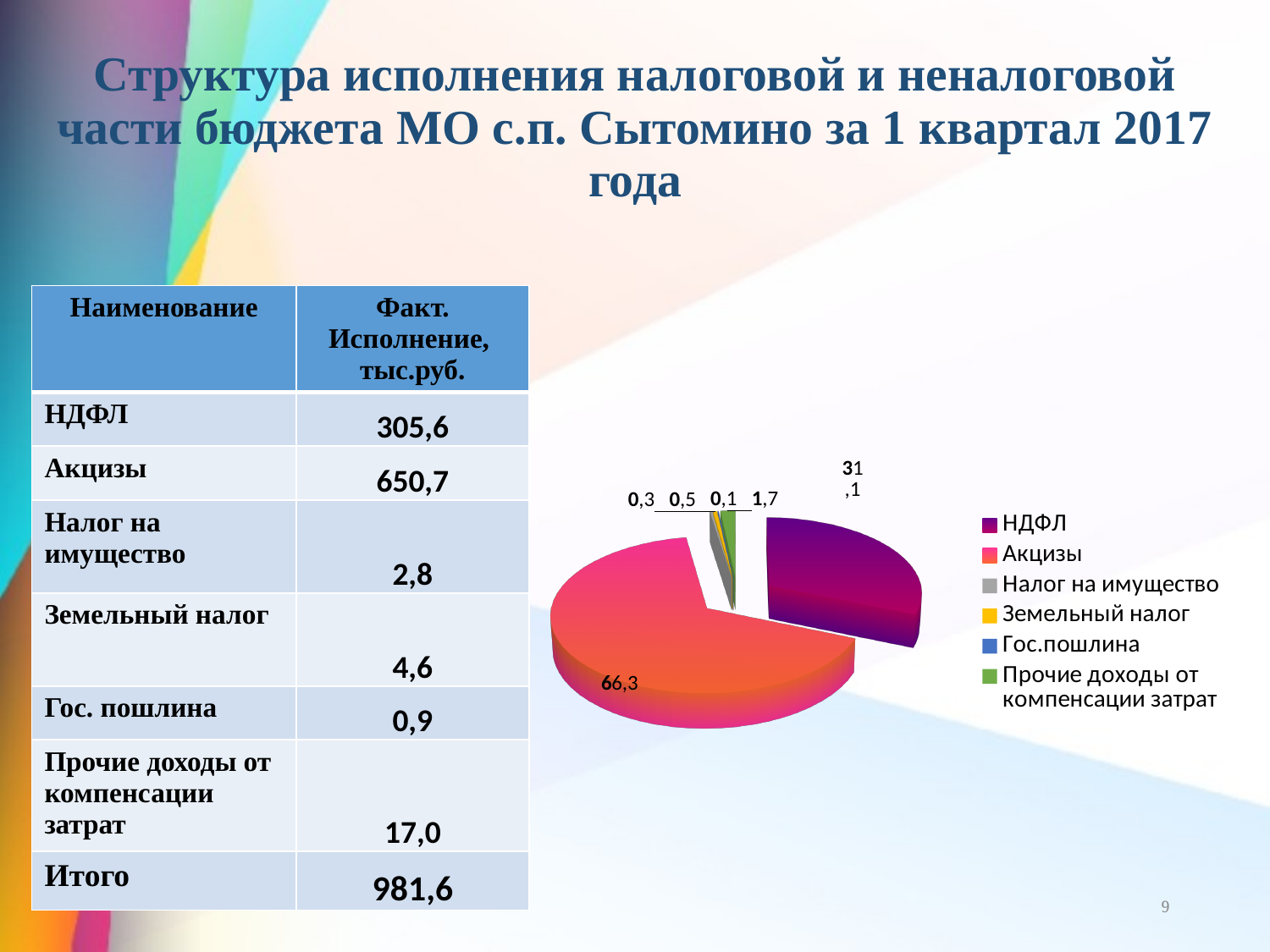
Which slice is larger in the pie chart, НДФЛ or Акцизы? Акцизы Which category has the largest slice in the pie chart? Акцизы What value is labelled on the Акцизы slice of the pie chart? 66,3 What value is labelled on the Прочие доходы от компенсации затрат slice of the pie chart? 1,7 What colour represents Акцизы in the pie chart legend? Red What is the difference between the Акцизы and НДФЛ values labelled on the pie chart? 35,2 What type of chart is shown on the slide? Pie chart What value is labelled on the НДФЛ slice of the pie chart? 31,1 How many entries does the legend of the pie chart list? 6 What value is labelled on the Гос.пошлина slice of the pie chart? 0,1 Which category has the smallest slice in the pie chart? Гос.пошлина How many slices does the pie chart have? 6